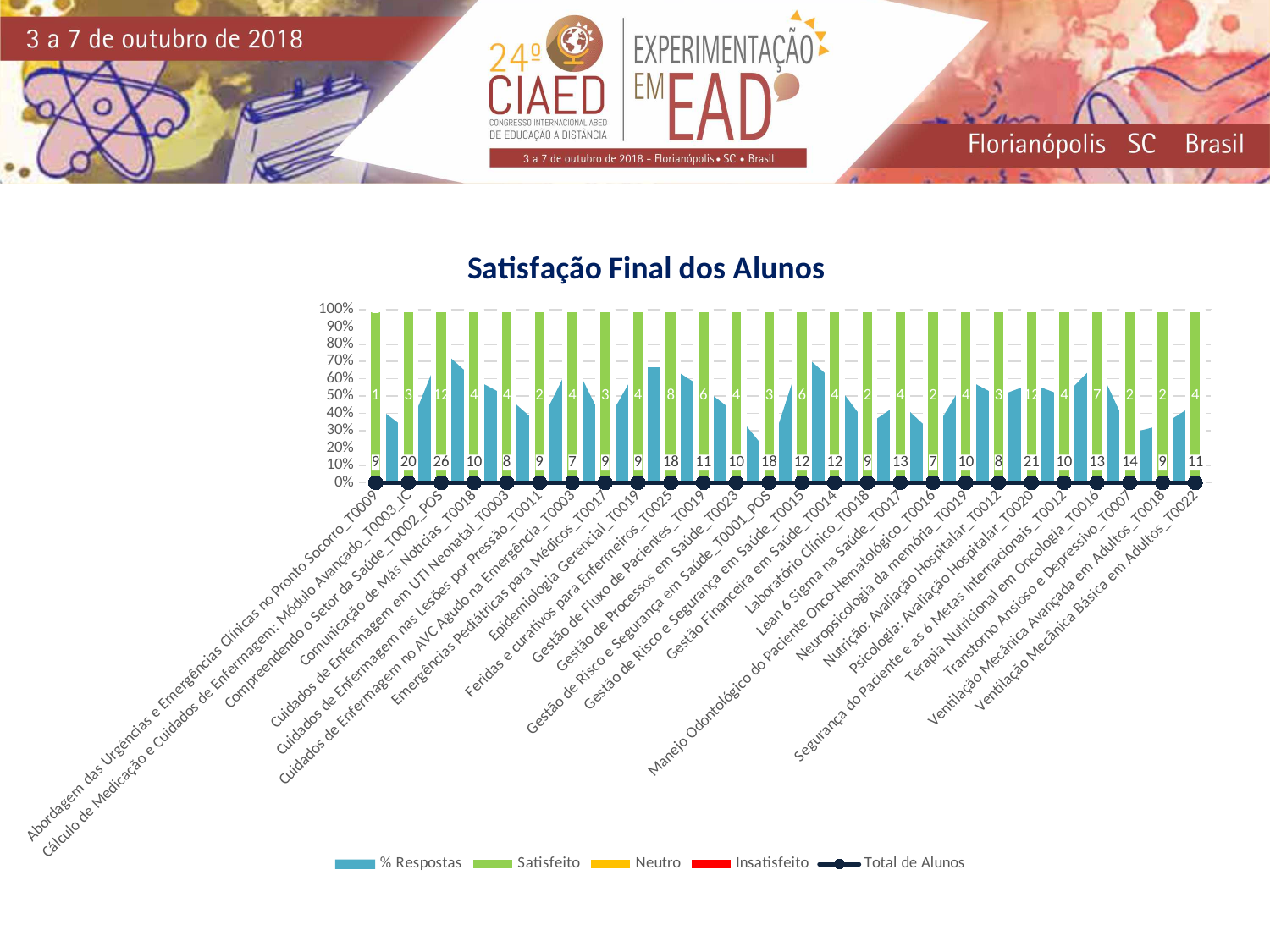
What kind of chart is shown on the slide? combination chart (area, bar and line) Which colour represents the 'Satisfeito' series in the chart legend? green Is the blue '% Respostas' bar for Gestão de Risco e Segurança em Saúde_T0001_POS greater or less than 40%? less Which is larger, the blue '% Respostas' bar for Feridas e curativos para Enfermeiros_T0025 or for Ventilação Mecânica Avançada em Adultos_T0018? Feridas e curativos para Enfermeiros_T0025 Is the blue '% Respostas' bar for Comunicação de Más Notícias_T0018 greater or less than 50%? greater How many series does the chart legend list? 5 What is the title of the chart? Satisfação Final dos Alunos What is the data label printed near the 10% level for Compreendendo o Setor da Saúde_T0002_POS? 26 How many categories (courses) are shown on the x axis of the chart? 26 What is the data label printed near the 10% level for Psicologia: Avaliação Hospitalar_T0020? 21